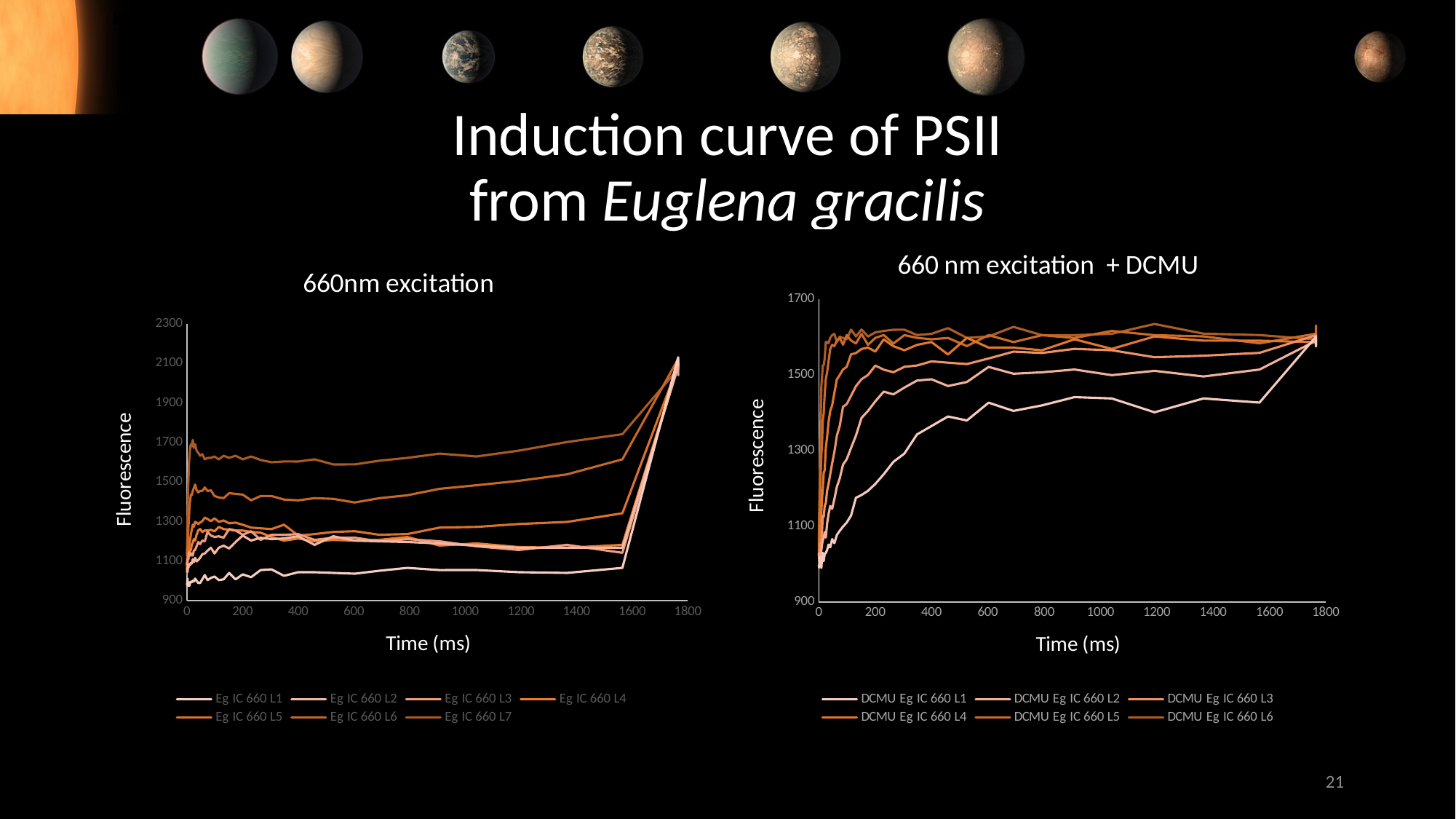
What kind of chart is the left chart titled "660nm excitation"? line chart How many series does the legend of the left chart (660nm excitation) list? 7 In the left chart (660nm excitation), is the value of the highest line at 1000 ms greater or less than 1500? greater In the right chart (660 nm excitation + DCMU), does the lowest line generally rise or fall from 0 ms to 1800 ms? rise In the right chart (660 nm excitation + DCMU), is the value of the lowest line at 200 ms greater or less than 1300? less In the left chart (660nm excitation), is the peak value reached by the lines at the far right end (around 1750 ms) greater or less than 1900? greater What is the y-axis label of the left chart (660nm excitation)? Fluorescence What kind of chart is the right chart titled "660 nm excitation + DCMU"? line chart How many series does the legend of the right chart (660 nm excitation + DCMU) list? 6 What is the x-axis label of the right chart (660 nm excitation + DCMU)? Time (ms)